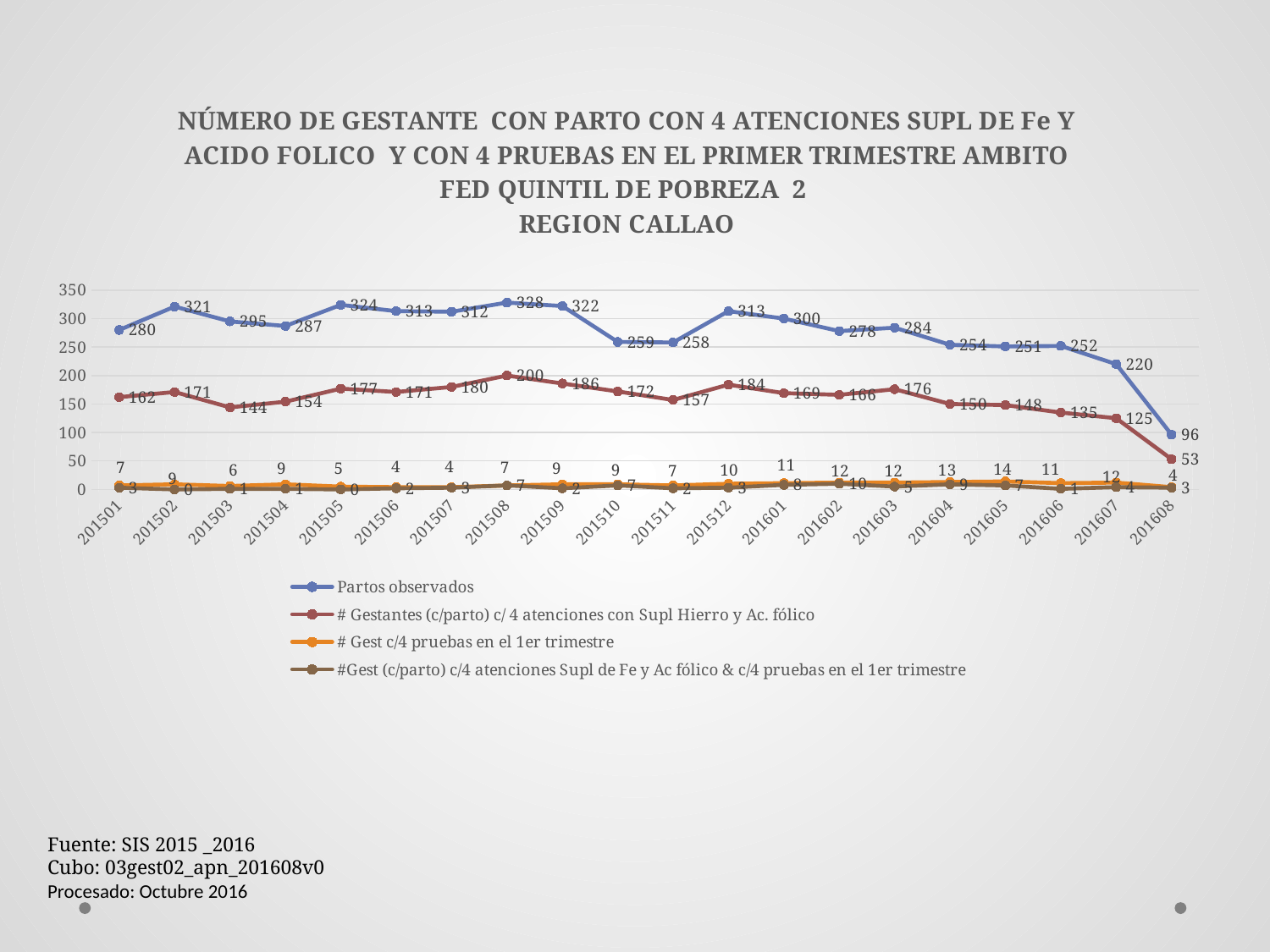
How many months are plotted on the x axis? 20 What is the value of Partos observados for 201508? 328 In which month is Partos observados at its lowest? 201608 Which region is named in the chart title? REGION CALLAO How many series does the legend list? 4 What is the value of '# Gestantes (c/parto) c/ 4 atenciones con Supl Hierro y Ac. fólico' for 201508? 200 In which month does Partos observados reach its highest value? 201508 What is the value of '# Gest c/4 pruebas en el 1er trimestre' for 201605? 14 What kind of chart is shown on the slide? Line chart What is the difference between Partos observados in 201501 and in 201608? 184 Does Partos observados rise or fall from 201606 to 201608? Fall Which month has a higher value for Partos observados, 201502 or 201512? 201502